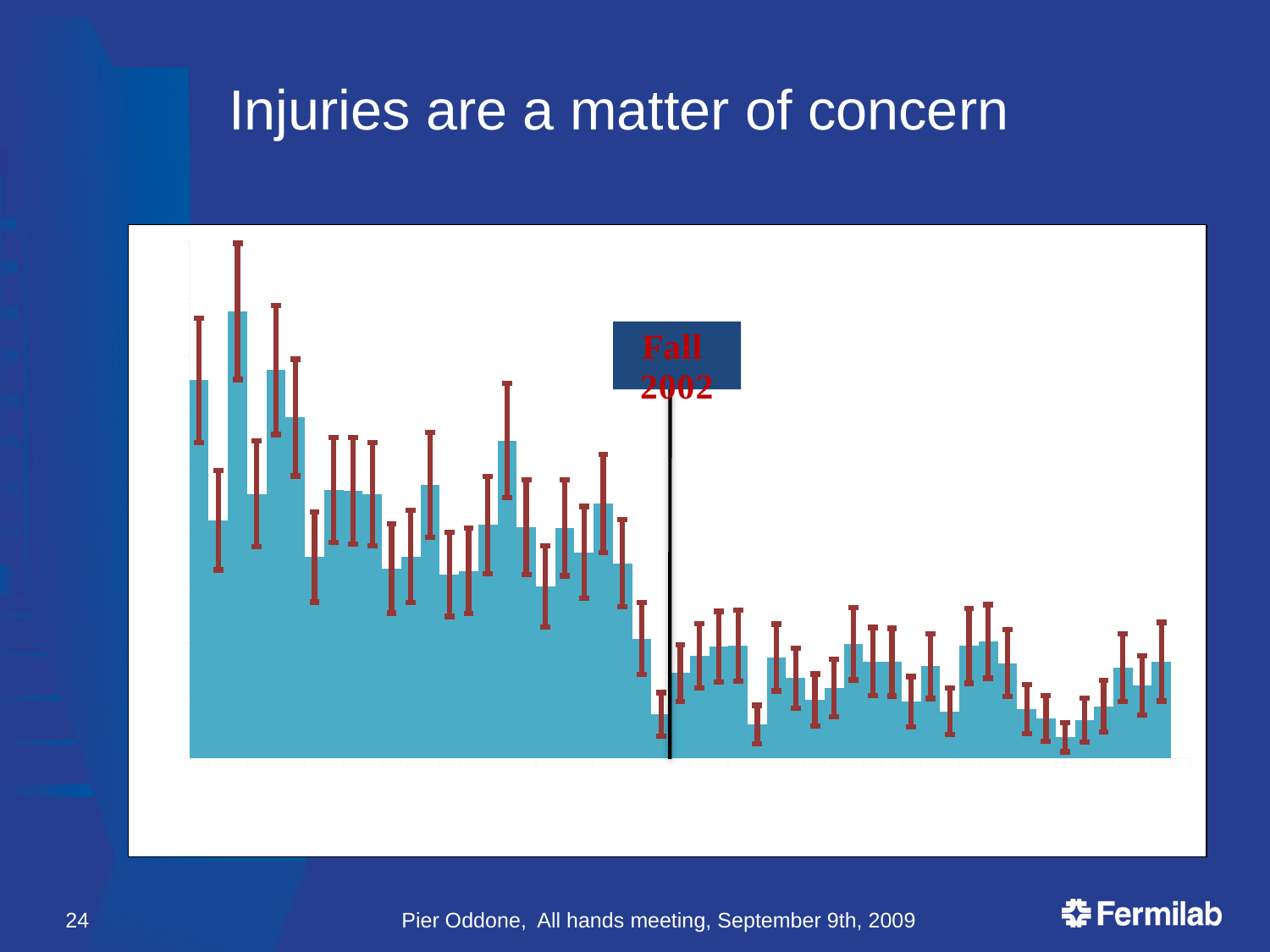
What colour are the bars in the chart? light blue Are the bars to the left of the vertical line generally higher or lower than the bars to the right of it? higher Do the bar values generally rise or fall from left to right across the chart? fall What kind of chart is shown on the slide? bar chart What label is written in the box above the vertical line on the chart? Fall 2002